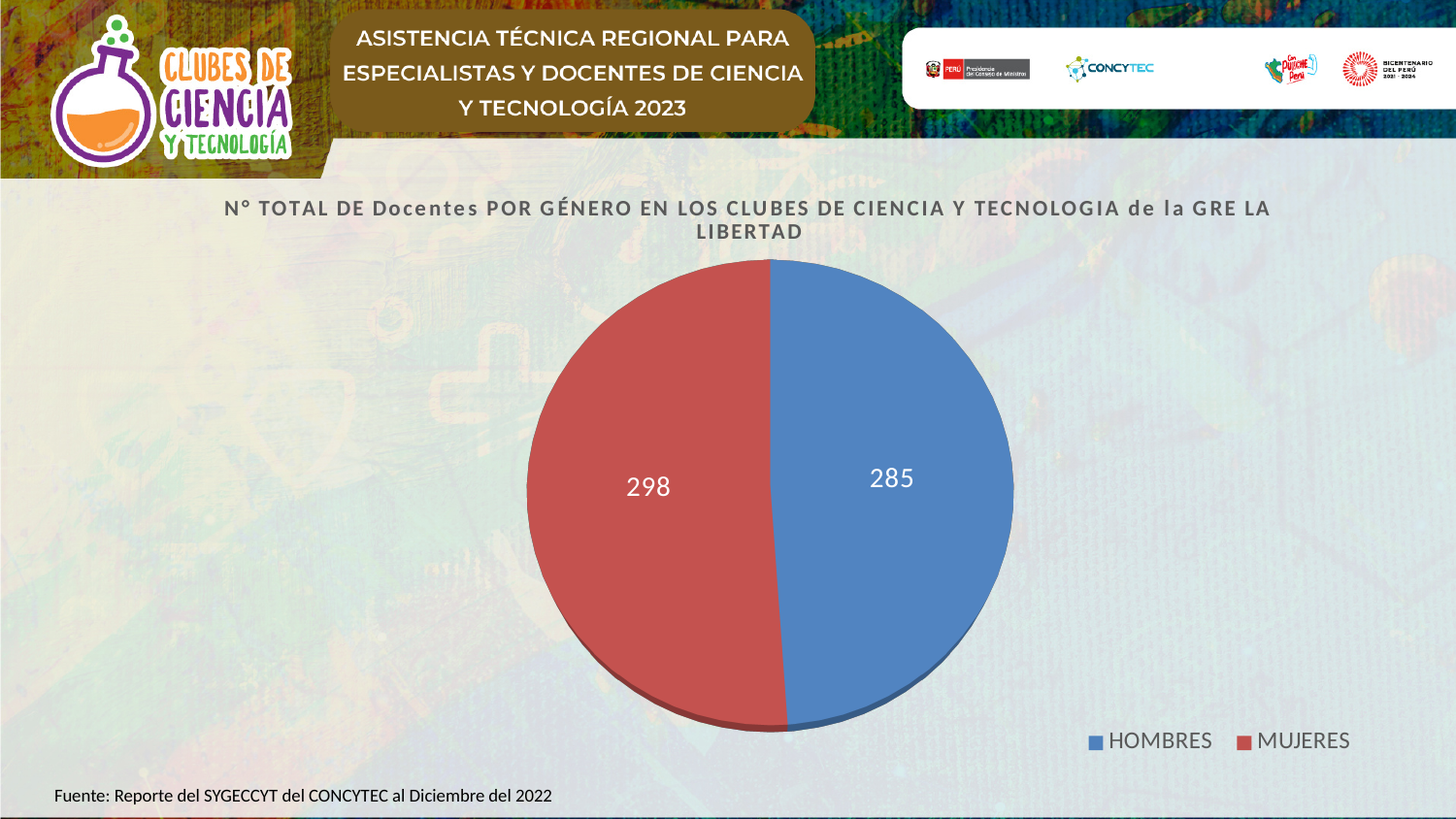
What is the difference between the values for MUJERES and HOMBRES? 13 What is the source cited below the chart? Reporte del SYGECCYT del CONCYTEC al Diciembre del 2022 What type of chart is shown on the slide? Pie chart What is the value for MUJERES in the pie chart? 298 What is the total of the two slices in the pie chart? 583 How many entries does the legend list? 2 Which category has the larger value, HOMBRES or MUJERES? MUJERES How many slices does the pie chart have? 2 Which category has the largest value in the pie chart? MUJERES What colour is the MUJERES slice in the pie chart? Red What is the value for HOMBRES in the pie chart? 285 Which category has the smallest value in the pie chart? HOMBRES